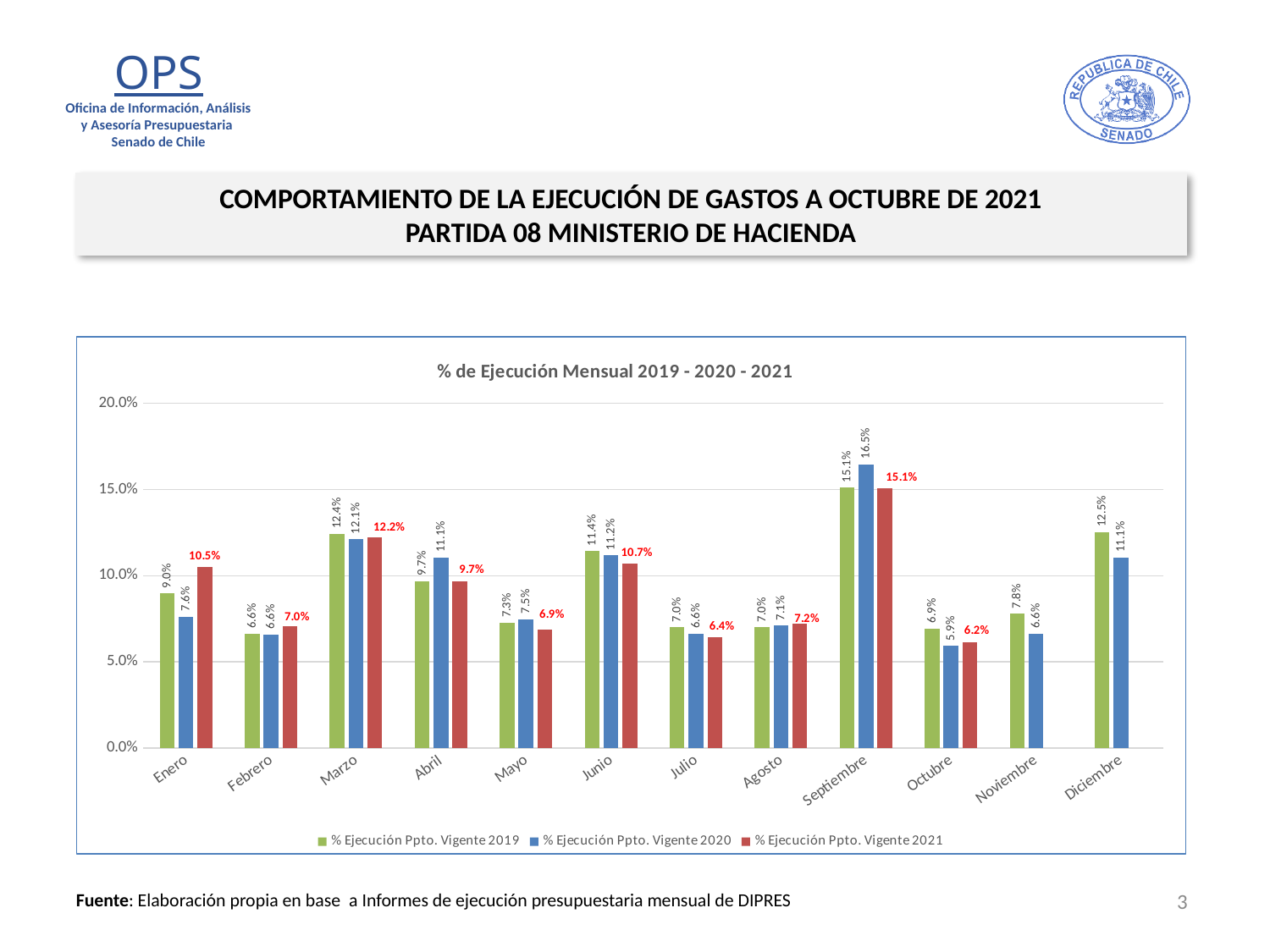
What kind of chart is shown? Bar chart Which month has the lowest value in the % Ejecución Ppto. Vigente 2020 series? Octubre What is the difference between the 2020 and 2019 values for Septiembre? 1.4% How many months are shown on the x axis? 12 Which month has the highest value in the % Ejecución Ppto. Vigente 2021 series? Septiembre Is the value for Marzo in the 2019 series greater or less than 10.0%? greater What is the value for Diciembre in the % Ejecución Ppto. Vigente 2019 series? 12.5% What is the value for Enero in the % Ejecución Ppto. Vigente 2021 series? 10.5% How many series does the legend list? 3 Which is larger for Abril: the 2020 value or the 2019 value? 2020 value What is the title of the chart? % de Ejecución Mensual 2019 - 2020 - 2021 What is the value for Septiembre in the % Ejecución Ppto. Vigente 2020 series? 16.5%